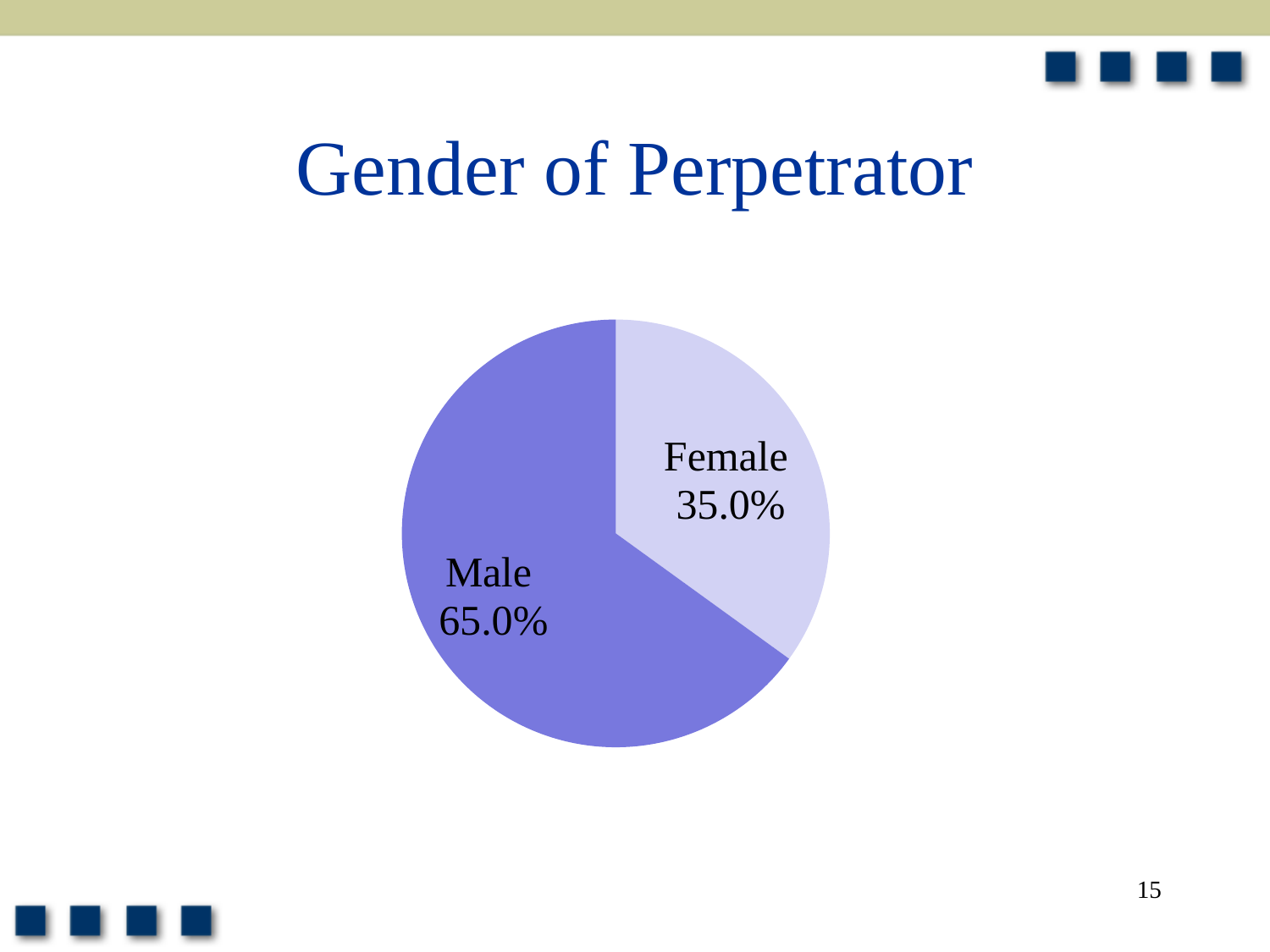
Which slice is larger, Male or Female? Male What share of the pie does the Female slice represent? 35.0% How many slices does the pie chart have? 2 Which gender has the largest share of the pie? Male What is the difference in percentage points between the Male and Female slices? 30.0% What is the title of the chart? Gender of Perpetrator What percentage of perpetrators are Female? 35.0% Which gender has the smallest share of the pie? Female Which slice is shown in the lighter colour? Female What percentage of perpetrators are Male? 65.0% What type of chart is shown on the slide? pie chart Is the Male share greater or less than 50%? greater